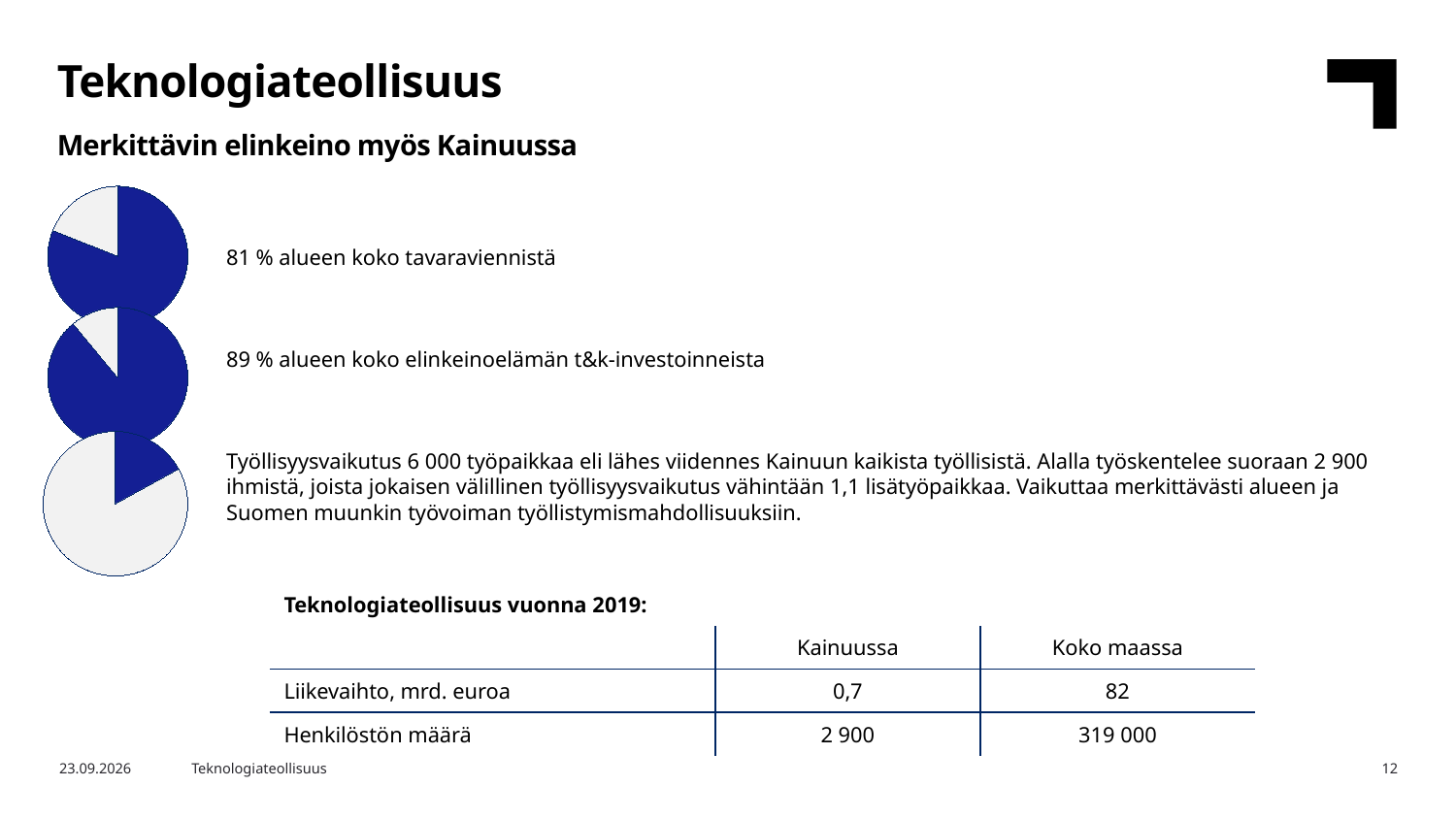
How many pie charts are on the slide? 3 What does the top pie chart illustrate, according to the text next to it? 81 % alueen koko tavaraviennistä What kind of chart is shown at the top left of the slide? Pie chart In the top pie chart, is the dark blue slice more or less than half of the pie? More In the bottom pie chart, is the dark blue slice more or less than half of the pie? Less Which pie chart has the larger dark blue slice, the top one or the middle one? The middle one What colour is the larger slice in the top pie chart? Dark blue In the middle pie chart, what share of the region's business R&D investments (t&k-investoinnit) does the dark blue slice represent? 89 % In the top pie chart, what share of the region's total goods exports (tavaravienti) does the dark blue slice represent? 81 % Which of the three pie charts has the smallest dark blue slice? The bottom one